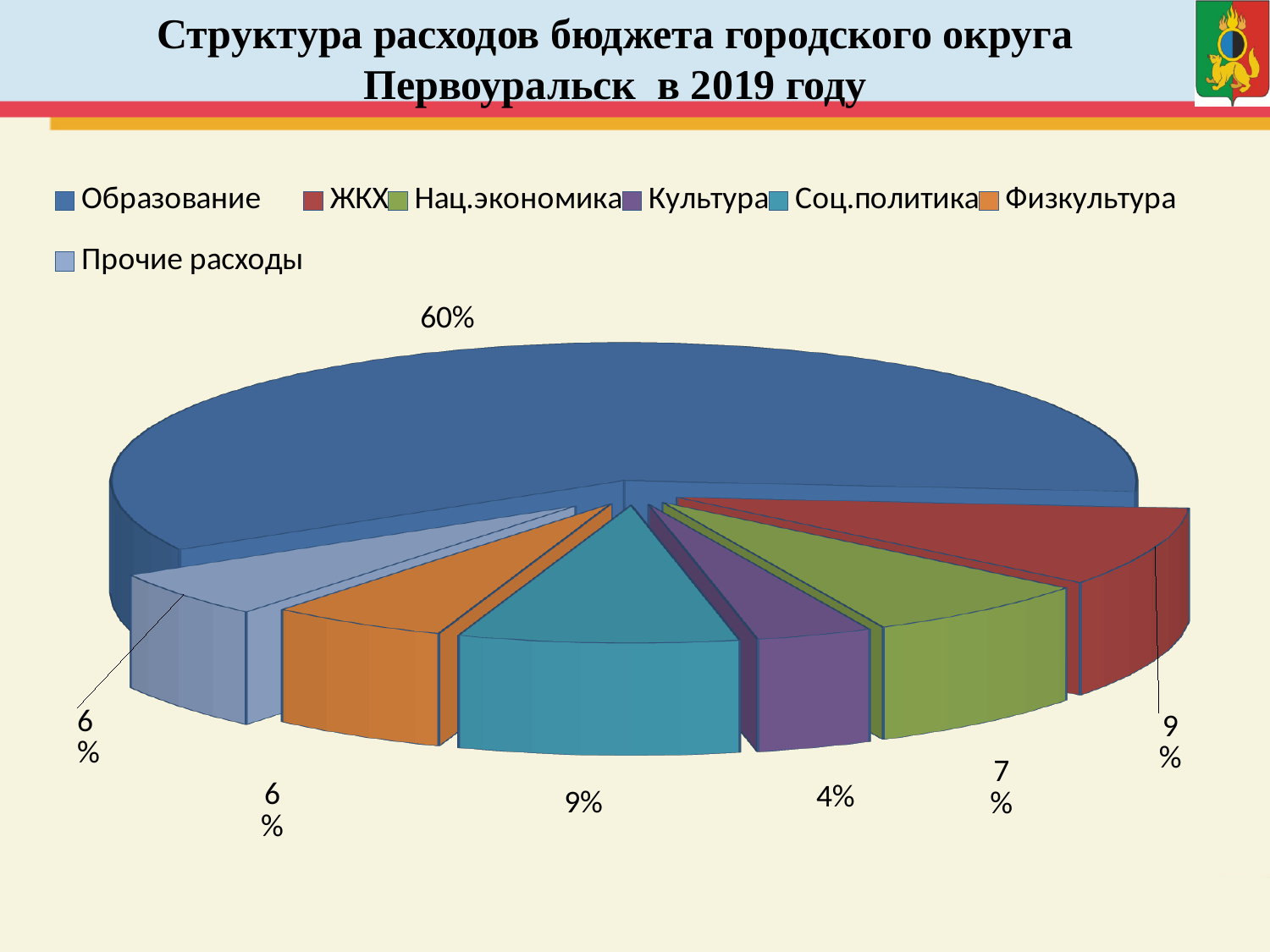
How many slices does the pie chart have? 7 By how many percentage points does Образование exceed ЖКХ? 51 What percentage is shown for ЖКХ? 9% What percentage is shown for Нац.экономика? 7% What share of the pie does Образование account for? 60% What percentage is shown for Культура? 4% What percentage is shown for Физкультура? 6% Which category has the smallest share of the budget expenditures? Культура What percentage is shown for Соц.политика? 9% What type of chart is shown on the slide? Pie chart Which is larger, the share for Нац.экономика or the share for Культура? Нац.экономика Which category has the largest share of the budget expenditures? Образование